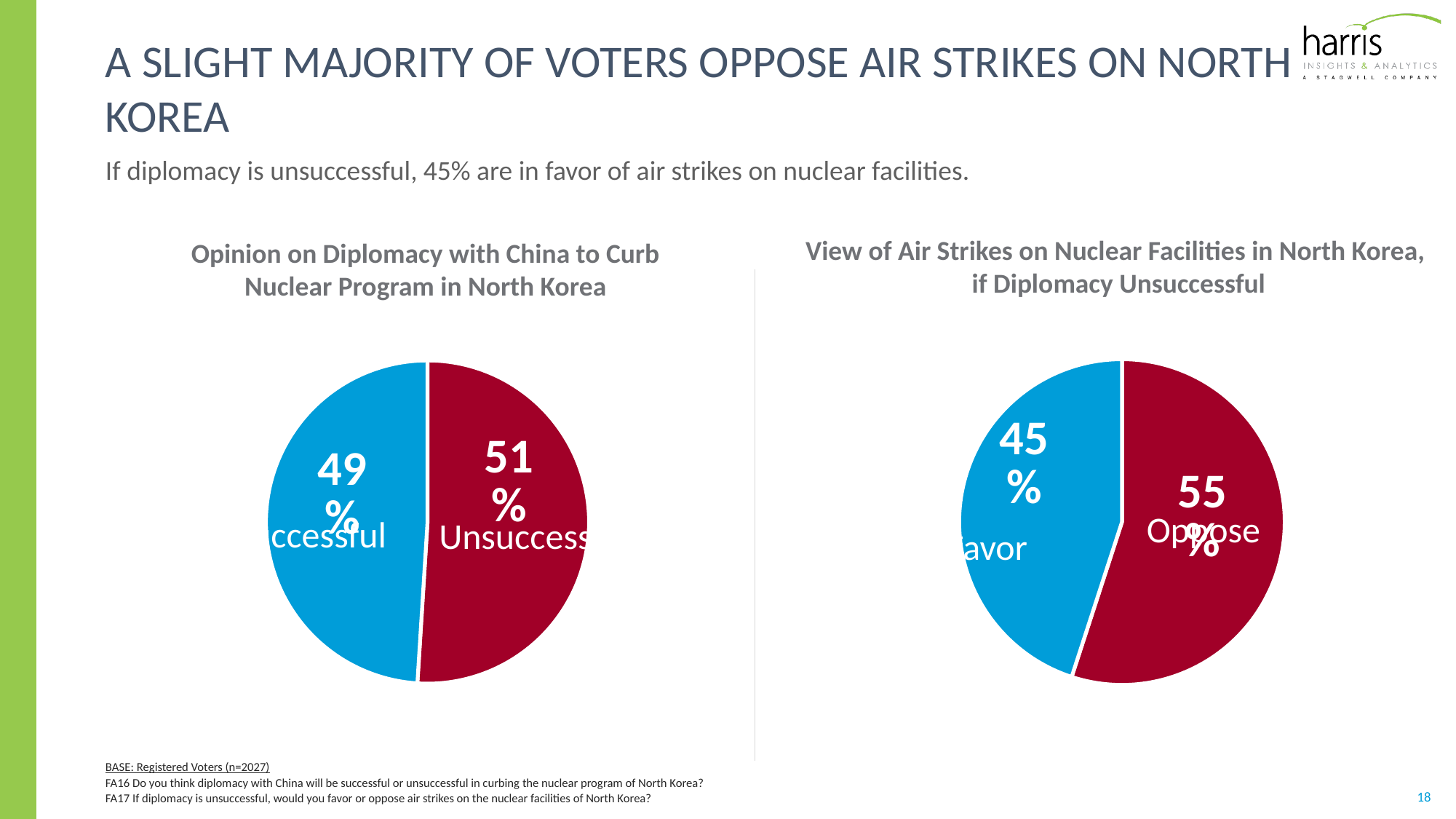
In the 'View of Air Strikes on Nuclear Facilities in North Korea, if Diplomacy Unsuccessful' chart, what share of voters favor air strikes? 45% In the left-hand chart on diplomacy with China, which response has the larger share? Unsuccessful In the right-hand chart on air strikes, which slice is larger: Favor or Oppose? Oppose In the right-hand chart on air strikes, what colour is the Oppose slice? Red What is the title of the left-hand chart on the slide? Opinion on Diplomacy with China to Curb Nuclear Program in North Korea In the 'View of Air Strikes on Nuclear Facilities in North Korea, if Diplomacy Unsuccessful' chart, what share of voters oppose air strikes? 55% What type of chart is used for 'View of Air Strikes on Nuclear Facilities in North Korea, if Diplomacy Unsuccessful'? Pie chart In the 'Opinion on Diplomacy with China to Curb Nuclear Program in North Korea' chart, what share of voters think diplomacy will be successful? 49% In the 'Opinion on Diplomacy with China to Curb Nuclear Program in North Korea' chart, what share of voters think diplomacy will be unsuccessful? 51% In the right-hand chart on air strikes, what is the difference in percentage points between Oppose and Favor? 10 percentage points How many slices does the 'Opinion on Diplomacy with China to Curb Nuclear Program in North Korea' pie chart have? 2 In the left-hand chart on diplomacy with China, what is the difference in percentage points between Unsuccessful and Successful? 2 percentage points